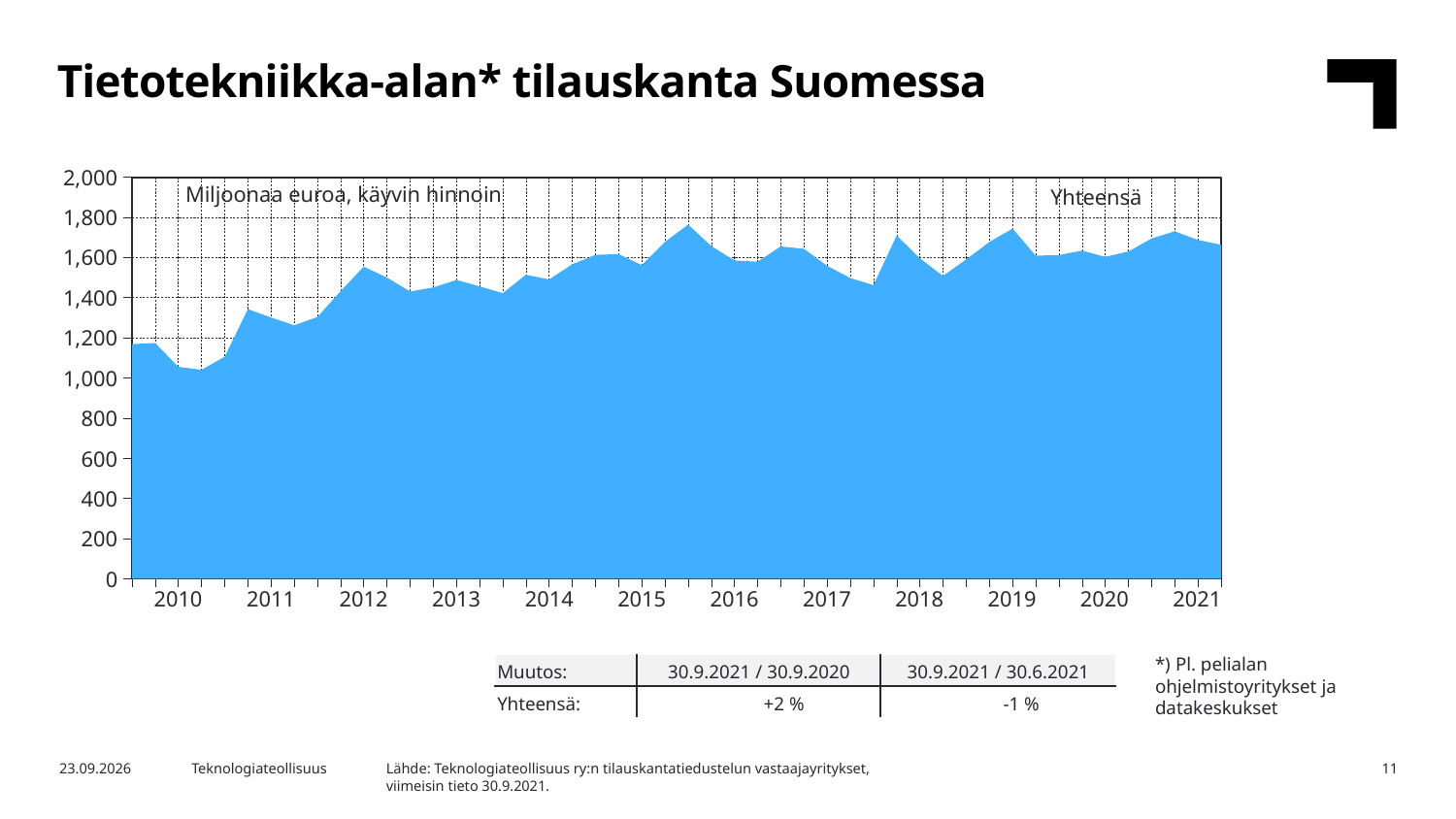
What is the name of the series plotted in the chart? Yhteensä Is the value at the end of 2021 greater or less than 1,400? greater What unit is the chart measured in, according to the label inside the plot area? Miljoonaa euroa, käyvin hinnoin Overall, does the order backlog rise or fall from 2010 to 2021? rise According to the table below the chart, what is the change for Yhteensä between 30.9.2020 and 30.9.2021? +2 % What kind of chart is shown on the slide? area chart Is the peak value in 2019 greater or less than 1,600? greater In which year does the chart reach its lowest value? 2010 How many years are labelled on the x axis? 12 Is the peak value in 2015 greater or less than 1,600? greater How many series does the chart show? 1